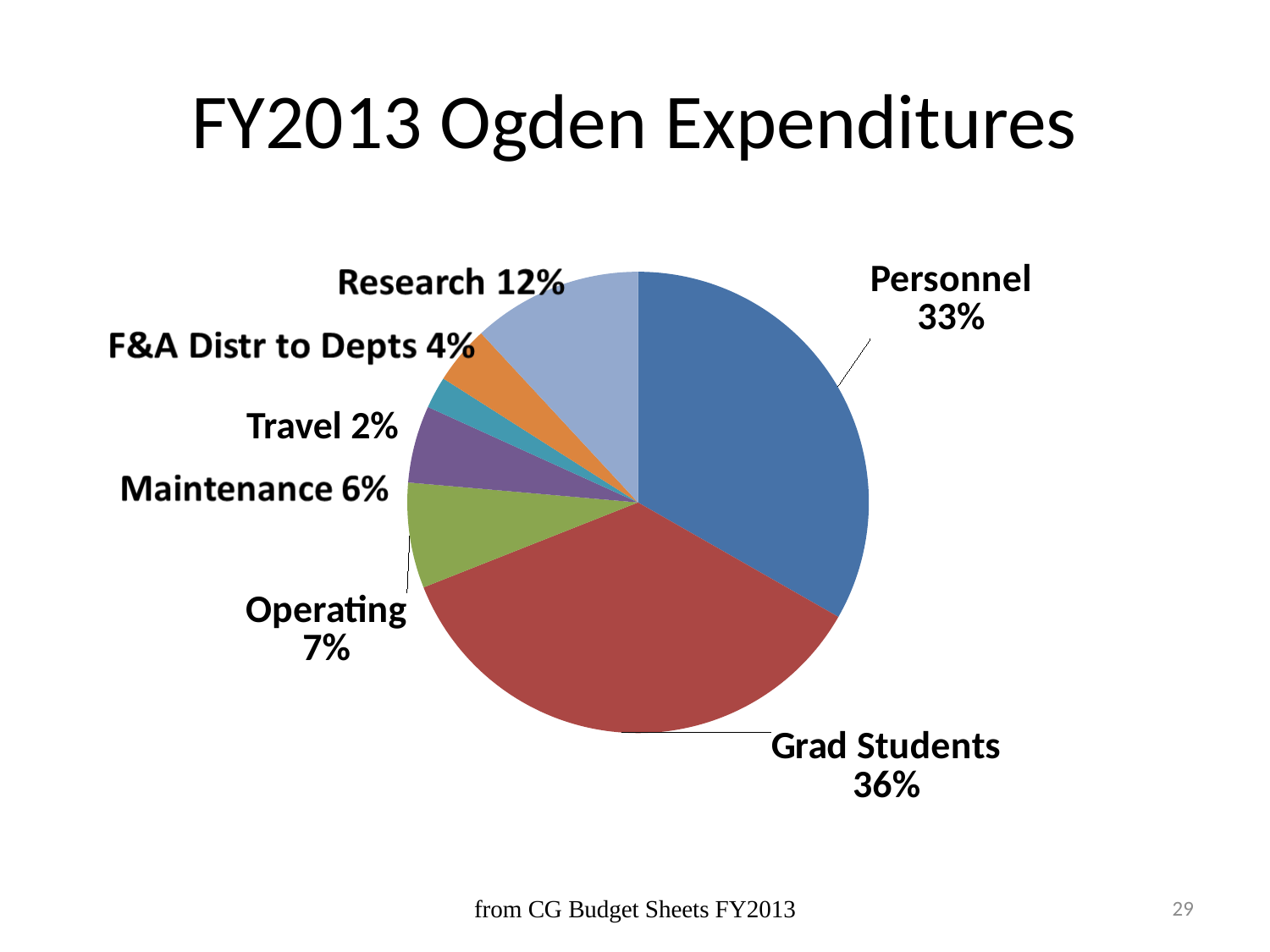
How many categories are shown in the pie chart? 7 Which category has the largest share of expenditures? Grad Students What is the title of the chart? FY2013 Ogden Expenditures Which category has the smallest share of expenditures? Travel What percentage is shown for F&A Distr to Depts? 4% What is the difference in percentage points between Grad Students and Personnel? 3 What percentage is shown for Maintenance? 6% What kind of chart is shown on the slide? pie chart Which is larger, Operating or Maintenance? Operating What share of FY2013 Ogden expenditures is Personnel? 33% What percentage is shown for Research? 12% What share of FY2013 Ogden expenditures is Grad Students? 36%